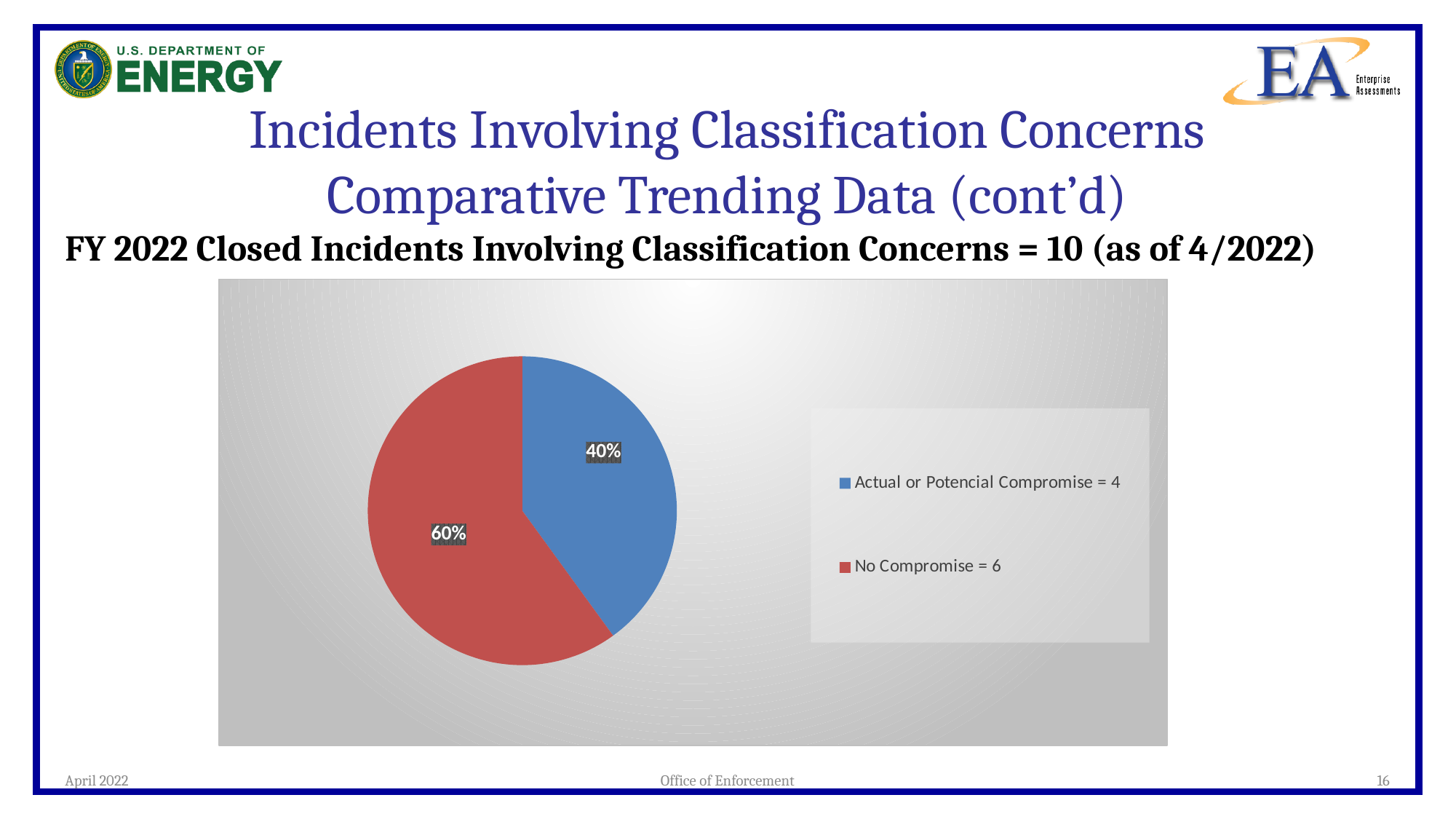
Which slice is the smallest in the pie chart? Actual or Potencial Compromise How many incidents does the legend give for 'Actual or Potencial Compromise'? 4 How many incidents does the legend give for 'No Compromise'? 6 How many slices does the pie chart have? 2 What percentage of the pie is labelled for the 'No Compromise' slice? 60% Which slice is the largest in the pie chart? No Compromise Which is larger, the 'No Compromise' slice or the 'Actual or Potencial Compromise' slice? No Compromise What is the total number of FY 2022 closed incidents involving classification concerns stated above the chart? 10 What kind of chart is shown on the slide? pie chart What colour is the 'No Compromise' slice in the pie chart? red What percentage of the pie is labelled for the 'Actual or Potencial Compromise' slice? 40% What is the difference in percentage points between the 'No Compromise' and 'Actual or Potencial Compromise' slices? 20%